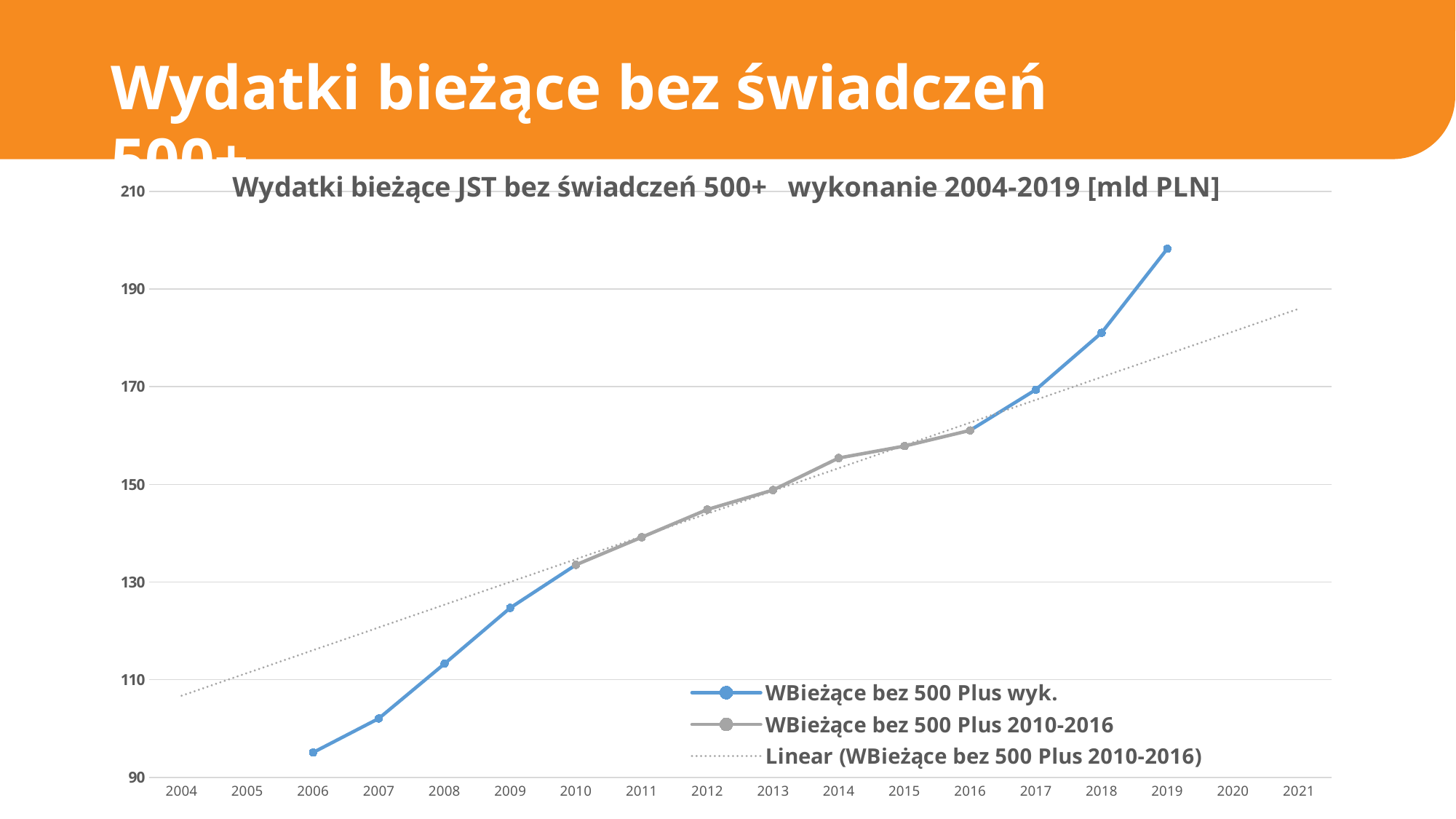
What is the title of the chart? Wydatki bieżące JST bez świadczeń 500+ wykonanie 2004-2019 [mld PLN] Do the values of 'WBieżące bez 500 Plus wyk.' rise or fall from 2006 to 2019? rise Is the value for 2006 in the series 'WBieżące bez 500 Plus wyk.' greater or less than 110? less Which year has the highest value for the series 'WBieżące bez 500 Plus wyk.'? 2019 Is the value for 2018 in the series 'WBieżące bez 500 Plus wyk.' greater or less than 170? greater Is the value for 2012 in the series 'WBieżące bez 500 Plus 2010-2016' greater or less than 150? less Which is larger: the value for 2014 or the value for 2009? 2014 How many series does the legend list? 3 Which year has the lowest value for the series 'WBieżące bez 500 Plus wyk.'? 2006 Which legend entry is drawn as a dotted line? Linear (WBieżące bez 500 Plus 2010-2016) What kind of chart is shown on the slide? line chart